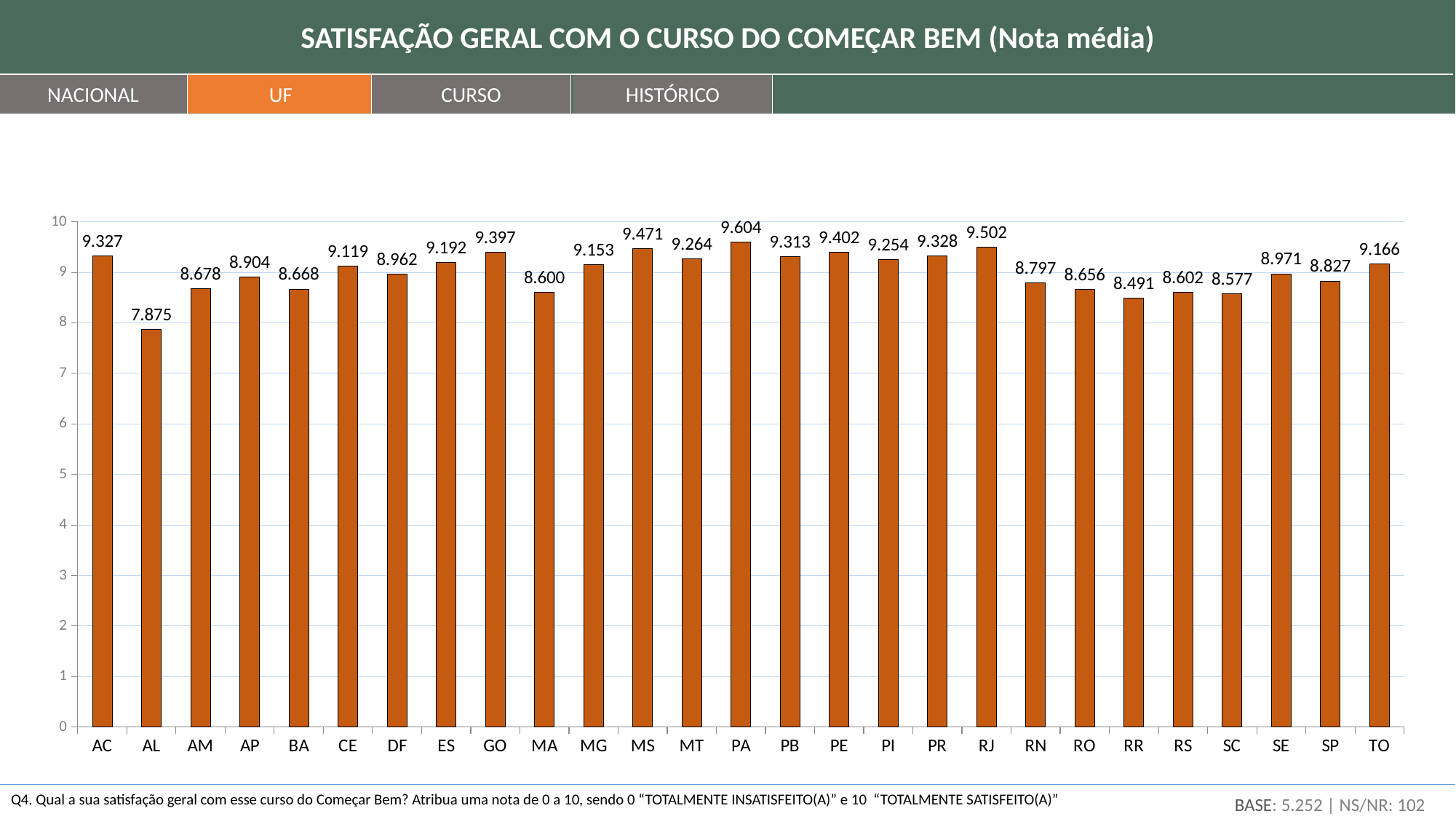
How many states (UF) are shown on the x axis? 27 What is the average score for PA? 9.604 Which has a higher score, GO or MA? GO What is the average score for RR? 8.491 What is the average score for DF? 8.962 What is the difference between the scores for RJ and RN? 0.705 What is the title of the chart? SATISFAÇÃO GERAL COM O CURSO DO COMEÇAR BEM (Nota média) Is the value for AL greater or less than 8? less Which state has the lowest average score? AL What kind of chart is shown on the slide? bar chart Which state has the highest average score? PA What is the difference between the scores for PA and AL? 1.729